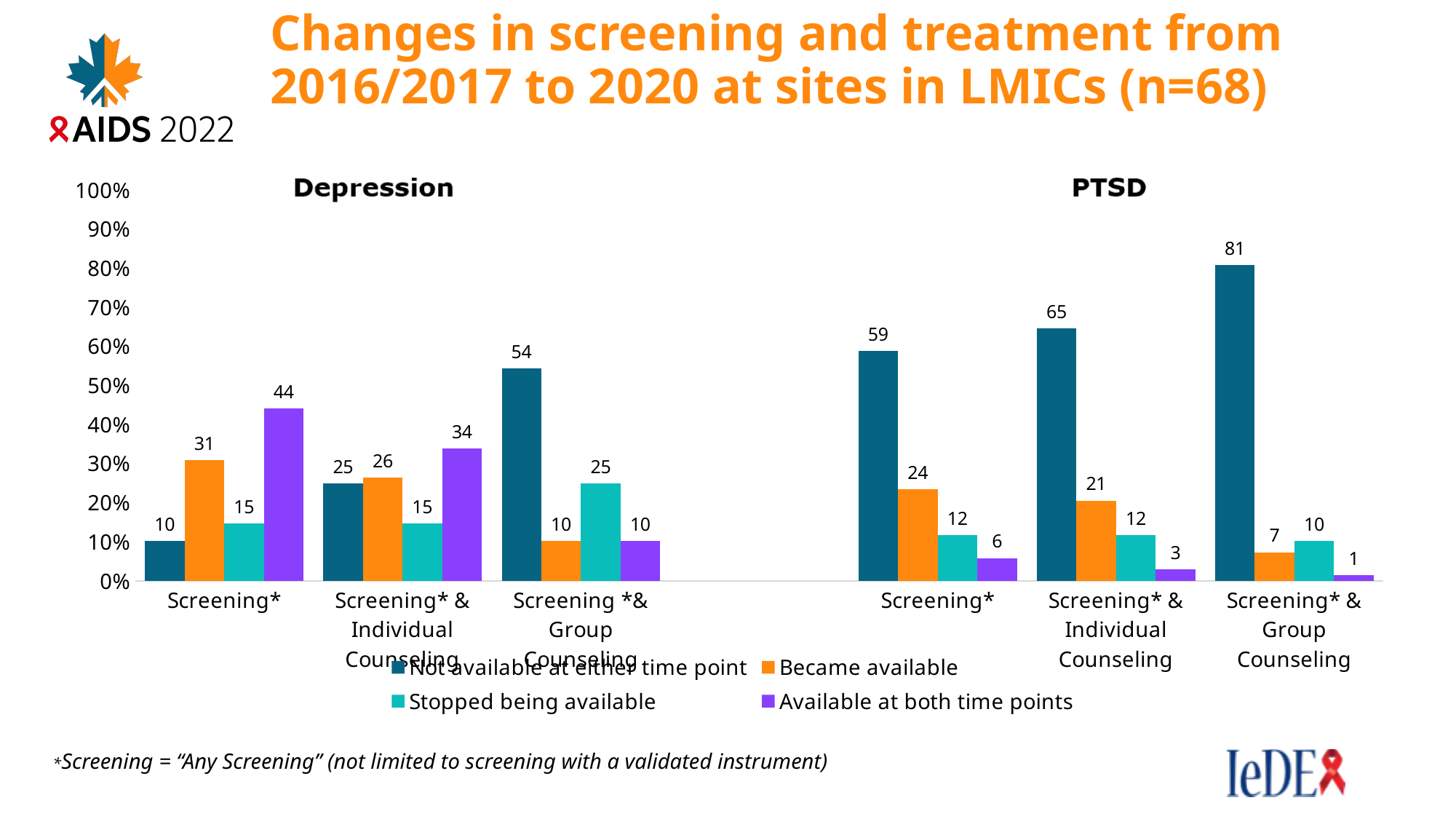
What is the value for "Not available at either time point" for Screening* & Group Counseling under PTSD? 81 Which is larger: "Became available" for Screening* under Depression or "Became available" for Screening* under PTSD? Screening* under Depression What is the value for "Available at both time points" for Screening* under Depression? 44 What is the difference between the "Not available at either time point" values for Screening* under PTSD and Screening* under Depression? 49 How does the "Not available at either time point" value change across the three PTSD categories from left to right? It rises How many series does the legend list? 4 What is the value for "Became available" for Screening* & Individual Counseling under PTSD? 21 What is the value for "Stopped being available" for Screening* & Group Counseling under Depression? 25 What kind of chart is shown on the slide? Bar chart Which category under PTSD has the highest value for "Not available at either time point"? Screening* & Group Counseling Which legend entry is shown in orange? Became available Which category under PTSD has the lowest value for "Available at both time points"? Screening* & Group Counseling